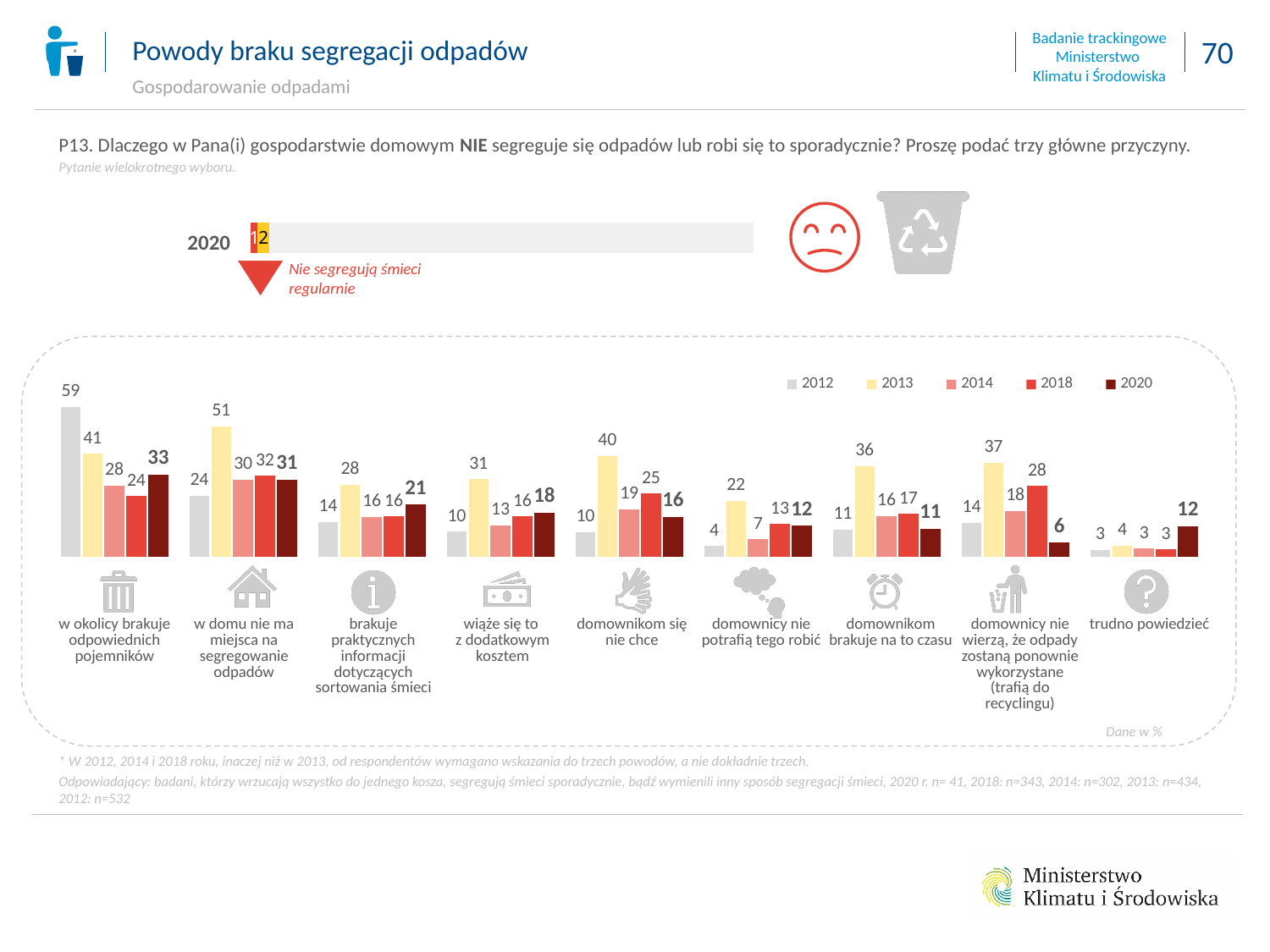
How many series does the legend of the main bar chart list? 5 In the main bar chart, which category has the lowest 2020 value? domownicy nie wierzą, że odpady zostaną ponownie wykorzystane How many categories does the main bar chart show? 9 In the main bar chart, what is the 2012 value for 'domownicy nie potrafią tego robić'? 4 In the main bar chart, what is the 2018 value for 'domownicy nie wierzą, że odpady zostaną ponownie wykorzystane'? 28 In the main bar chart, which is larger for 'domownikom się nie chce': the 2018 value or the 2020 value? 2018 In the main bar chart, what is the 2020 value for 'trudno powiedzieć'? 12 What kind of chart is the main chart on the slide? bar chart In the main bar chart, which category has the highest 2012 value? w okolicy brakuje odpowiednich pojemników In the main bar chart, what is the 2020 value for 'w okolicy brakuje odpowiednich pojemników'? 33 In the main bar chart, what is the 2013 value for 'w domu nie ma miejsca na segregowanie odpadów'? 51 In the main bar chart, what is the difference between the 2012 and 2020 values for 'w okolicy brakuje odpowiednich pojemników'? 26